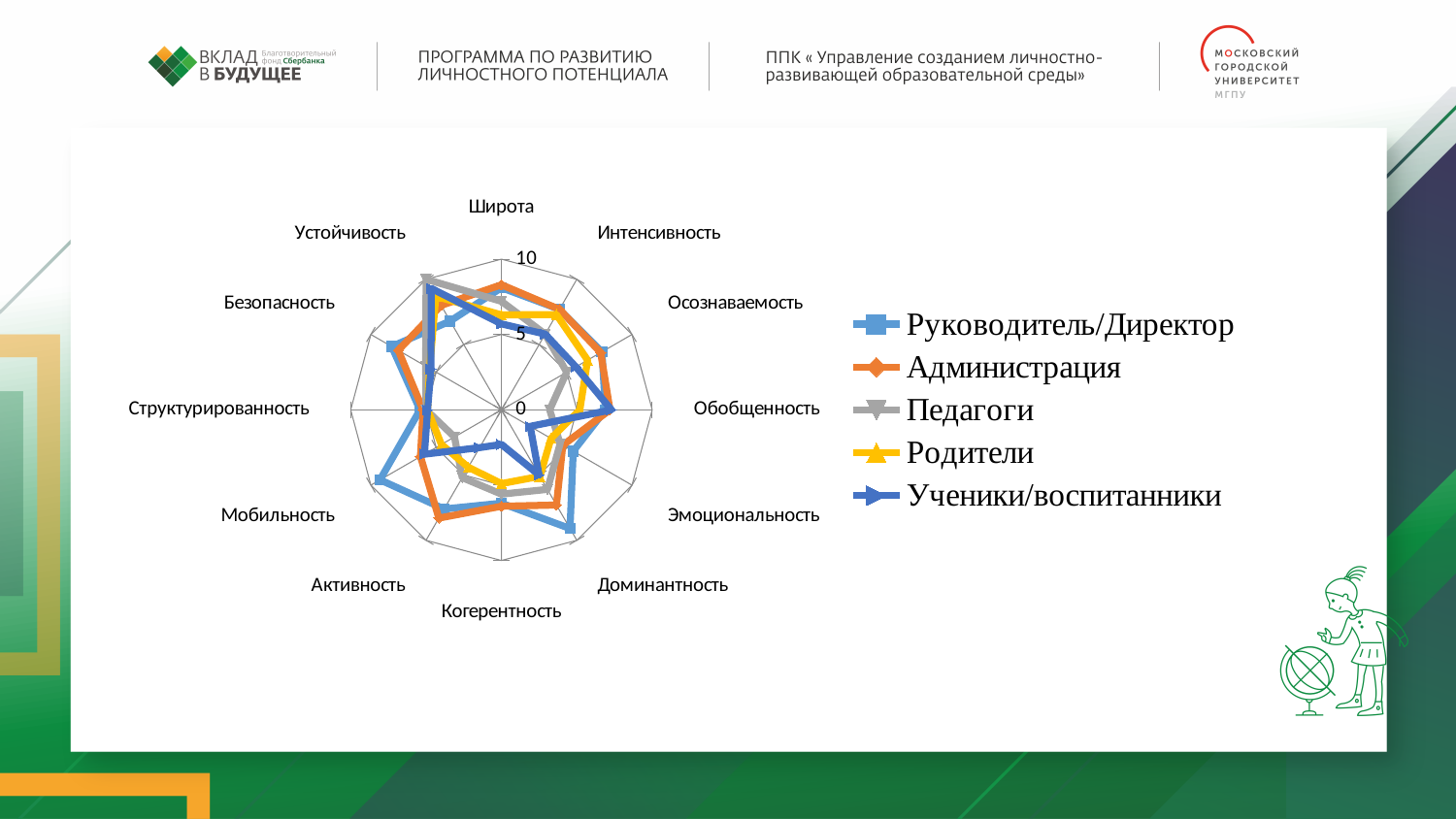
Which series is shown in orange in the legend? Администрация Is the value for Руководитель/Директор on Мобильность greater or less than 5? greater Is the value for Ученики/воспитанники on Обобщенность greater or less than 5? greater What is the maximum value shown on the radar chart's axis scale? 10 How many series does the legend list? 5 What kind of chart is shown on the slide? radar chart Is the value for Ученики/воспитанники on Когерентность greater or less than 5? less Which series is shown in yellow in the legend? Родители How many categories (axes) does the radar chart have? 12